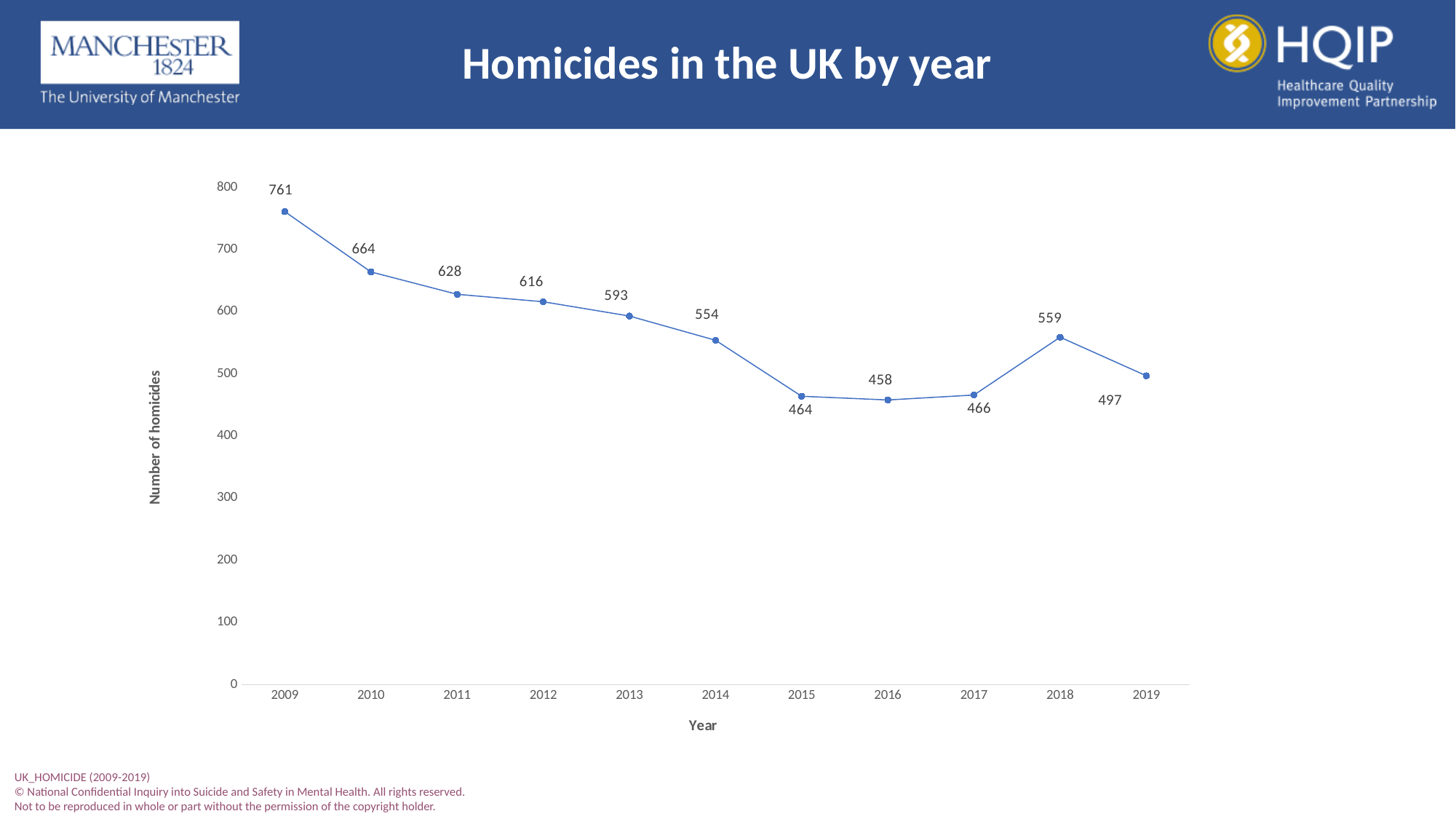
How many years are plotted on the chart? 11 What is the difference in the number of homicides between 2018 and 2017? 93 Which year has the highest number of homicides? 2009 What is the number of homicides in 2016? 458 What is the number of homicides in 2019? 497 Which year has more homicides, 2014 or 2018? 2018 Is the number of homicides in 2013 greater or less than 500? greater Which year has the lowest number of homicides? 2016 What is the difference in the number of homicides between 2009 and 2010? 97 What is the label of the y axis? Number of homicides What kind of chart is shown on the slide? line chart What is the number of homicides in 2009? 761